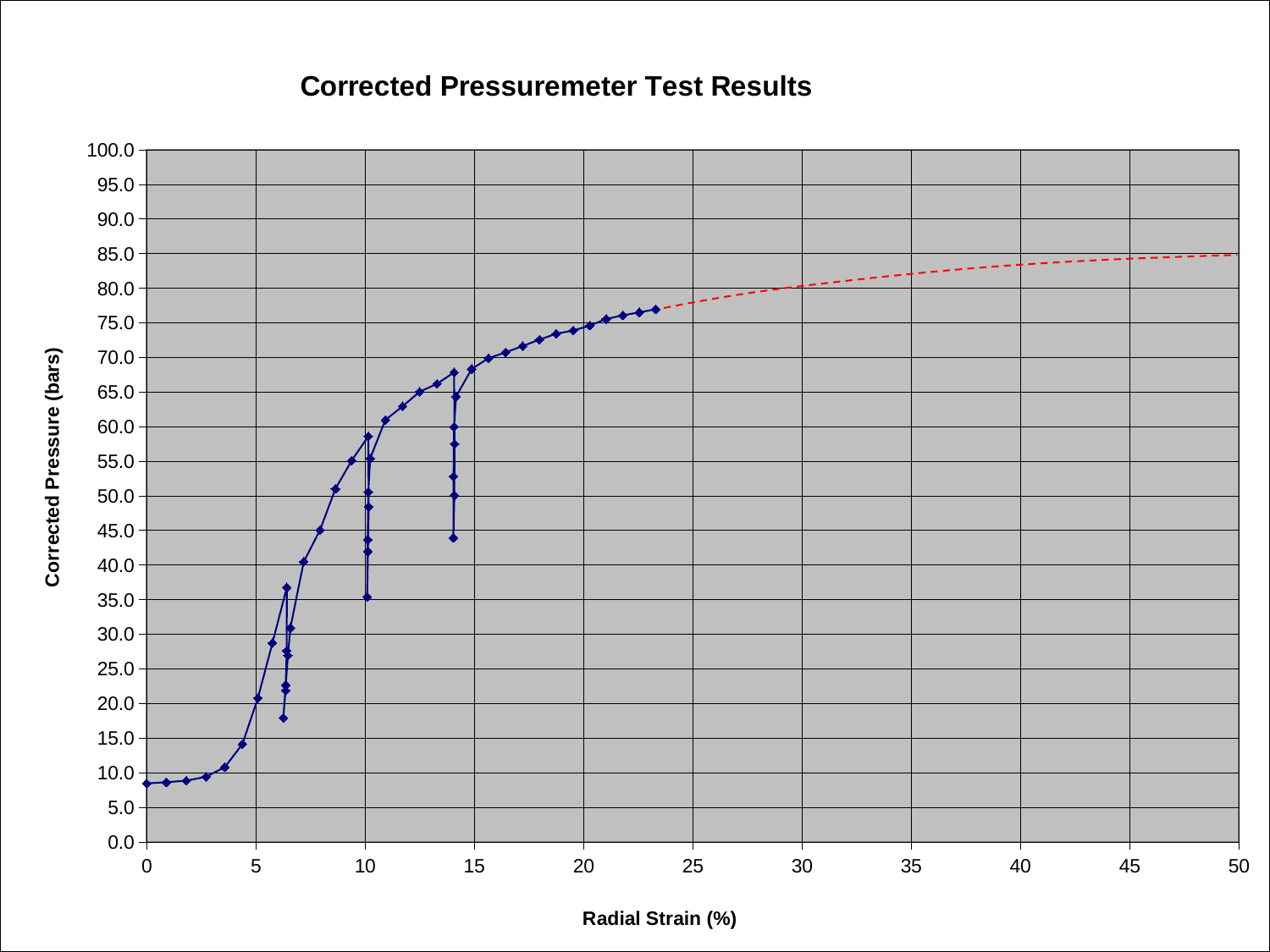
Is the value of the red dashed line at a radial strain of 50% greater or less than 90.0 bars? less Is the corrected pressure at a radial strain of 3% greater or less than 15.0 bars? less What is the title of the chart? Corrected Pressuremeter Test Results Is the corrected pressure at a radial strain of 15% greater or less than 60.0 bars? greater What type of chart is shown on the slide? line chart What is the label of the x axis? Radial Strain (%) Overall, does the corrected pressure rise or fall as radial strain increases from 0% to 50%? rise